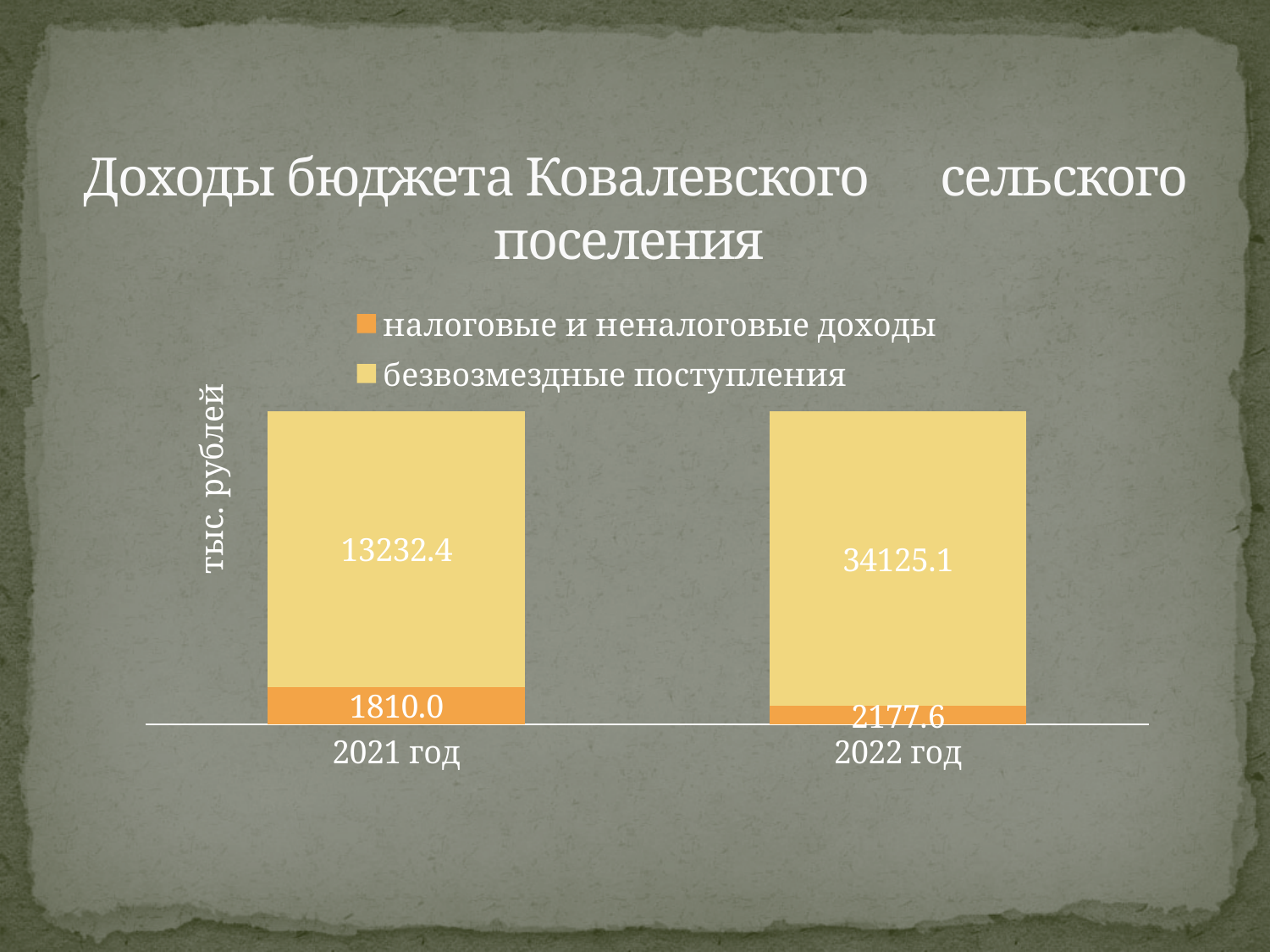
How many series does the legend list? 2 Which year has the higher value for безвозмездные поступления? 2022 год What unit is shown on the vertical axis label? тыс. рублей What is the value of налоговые и неналоговые доходы for 2022 год? 2177.6 What is the value of безвозмездные поступления for 2022 год? 34125.1 What is the value of налоговые и неналоговые доходы for 2021 год? 1810.0 What is the difference between безвозмездные поступления in 2022 год and in 2021 год? 20892.7 Which year has the lower value for налоговые и неналоговые доходы? 2021 год What is the total of the stacked bar for 2022 год? 36302.7 What is the difference between налоговые и неналоговые доходы in 2022 год and in 2021 год? 367.6 What is the total of the stacked bar for 2021 год? 15042.4 What is the value of безвозмездные поступления for 2021 год? 13232.4